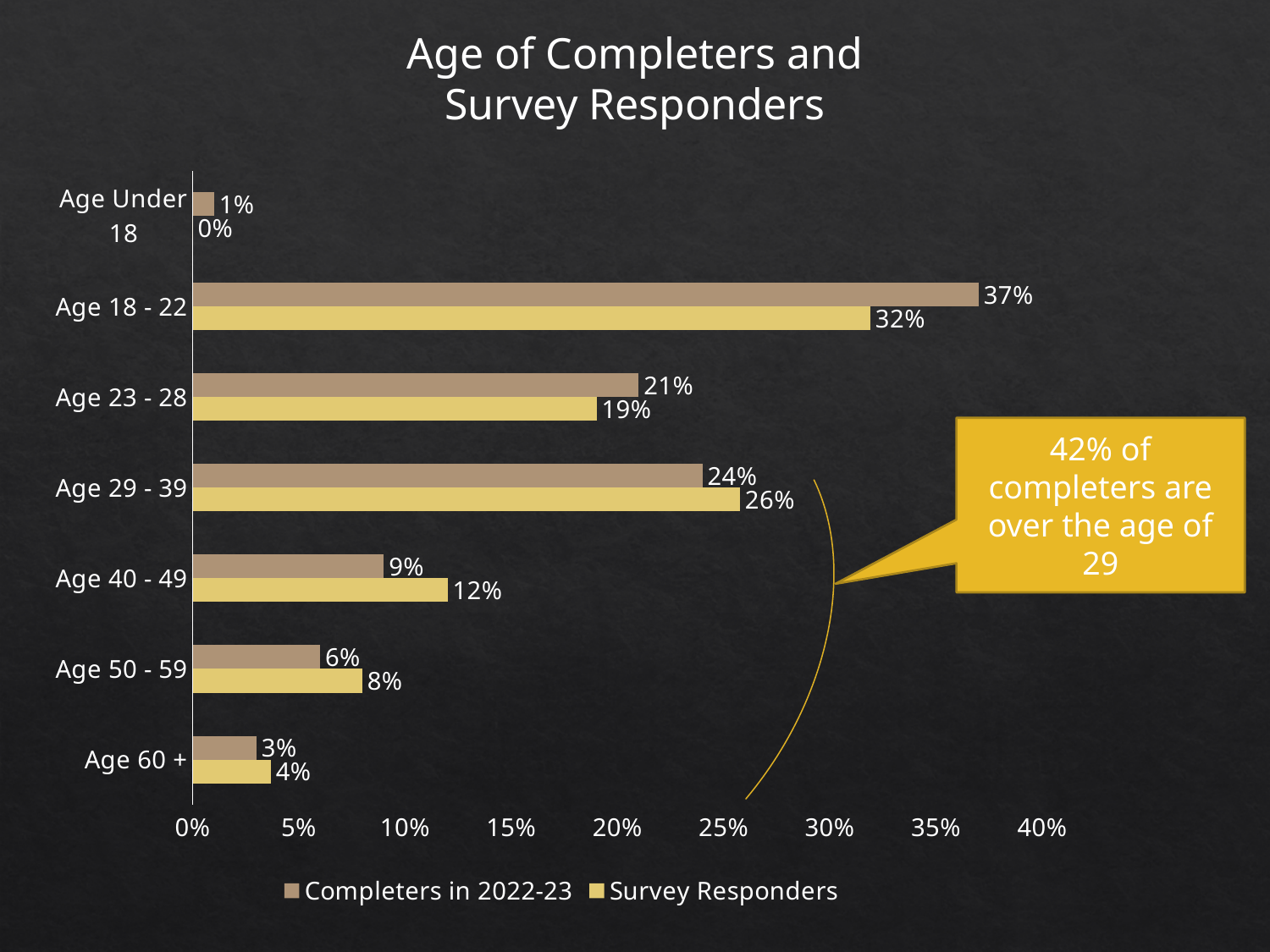
How many series does the legend list? 2 What percentage of Survey Responders are Age 40 - 49? 12% What percentage of Completers in 2022-23 are Age 18 - 22? 37% What is the difference between Completers in 2022-23 and Survey Responders for Age 18 - 22? 5% What percentage of Survey Responders are Age 29 - 39? 26% For Age 50 - 59, which is larger: Completers in 2022-23 or Survey Responders? Survey Responders Is the value for Completers in 2022-23 in Age 23 - 28 greater or less than 20%? greater Which age group has the highest percentage of Completers in 2022-23? Age 18 - 22 Which age group has the lowest percentage of Survey Responders? Age Under 18 What kind of chart is shown on the slide? Bar chart What is the title of the chart? Age of Completers and Survey Responders How many age groups are shown on the chart? 7